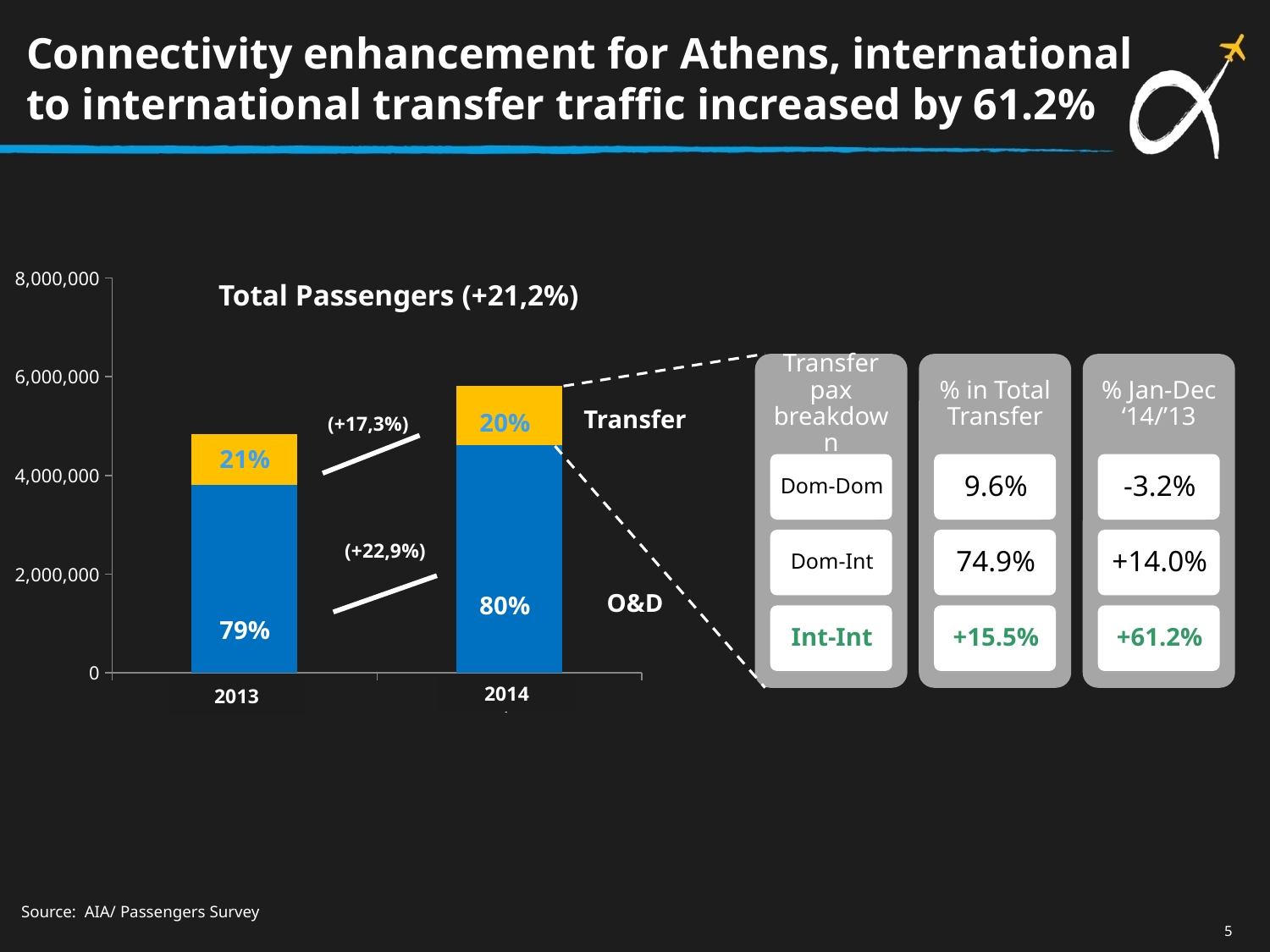
Which year has the taller total passengers bar, 2013 or 2014? 2014 What percentage of passengers in 2013 were O&D? 79% Is the total passenger bar for 2014 greater or less than 6,000,000? less What is the title of the chart? Total Passengers (+21,2%) What percentage of passengers in 2014 were Transfer? 20% What growth rate is annotated for O&D passengers between 2013 and 2014? (+22,9%) What percentage of passengers in 2013 were Transfer? 21% How many years (categories) are shown on the x axis of the chart? 2 Is the total passenger bar for 2013 greater or less than 4,000,000? greater What type of chart is shown on the slide? stacked bar chart What percentage of passengers in 2014 were O&D? 80% What growth rate is annotated for Transfer passengers between 2013 and 2014? (+17,3%)